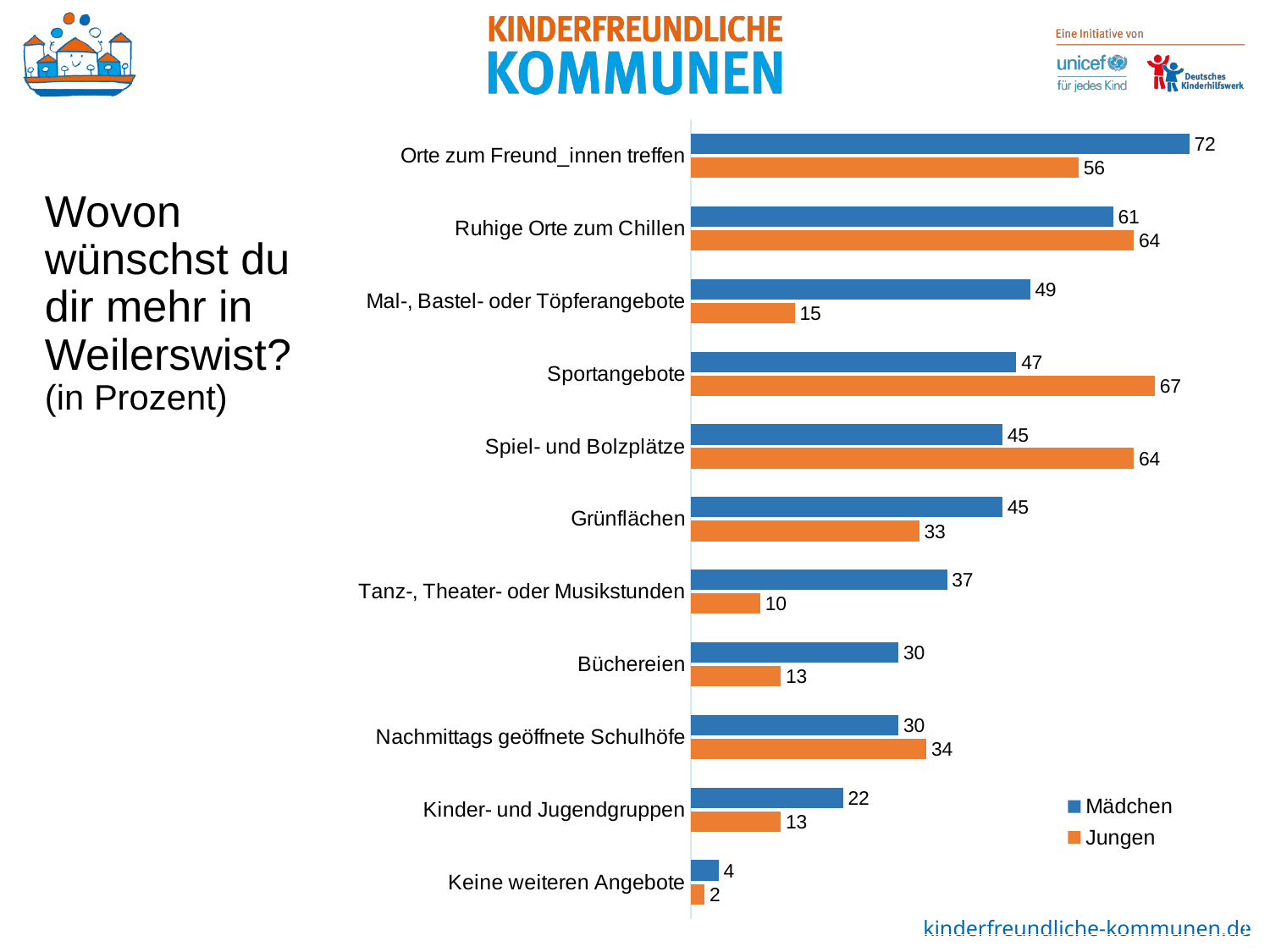
What is the value for Mädchen for "Orte zum Freund_innen treffen"? 72 Which category has the highest value for Mädchen? Orte zum Freund_innen treffen What kind of chart is shown on the slide? Bar chart What is the difference between the Mädchen and Jungen values for "Mal-, Bastel- oder Töpferangebote"? 34 What is the value for Jungen for "Sportangebote"? 67 Which category has the lowest value for Jungen? Keine weiteren Angebote Which colour represents Jungen in the chart? Orange For "Spiel- und Bolzplätze", which is larger, the Mädchen value or the Jungen value? Jungen What is the value for Jungen for "Tanz-, Theater- oder Musikstunden"? 10 How many series does the legend list? 2 How many categories are shown in the chart? 11 What is the difference between the Jungen and Mädchen values for "Sportangebote"? 20